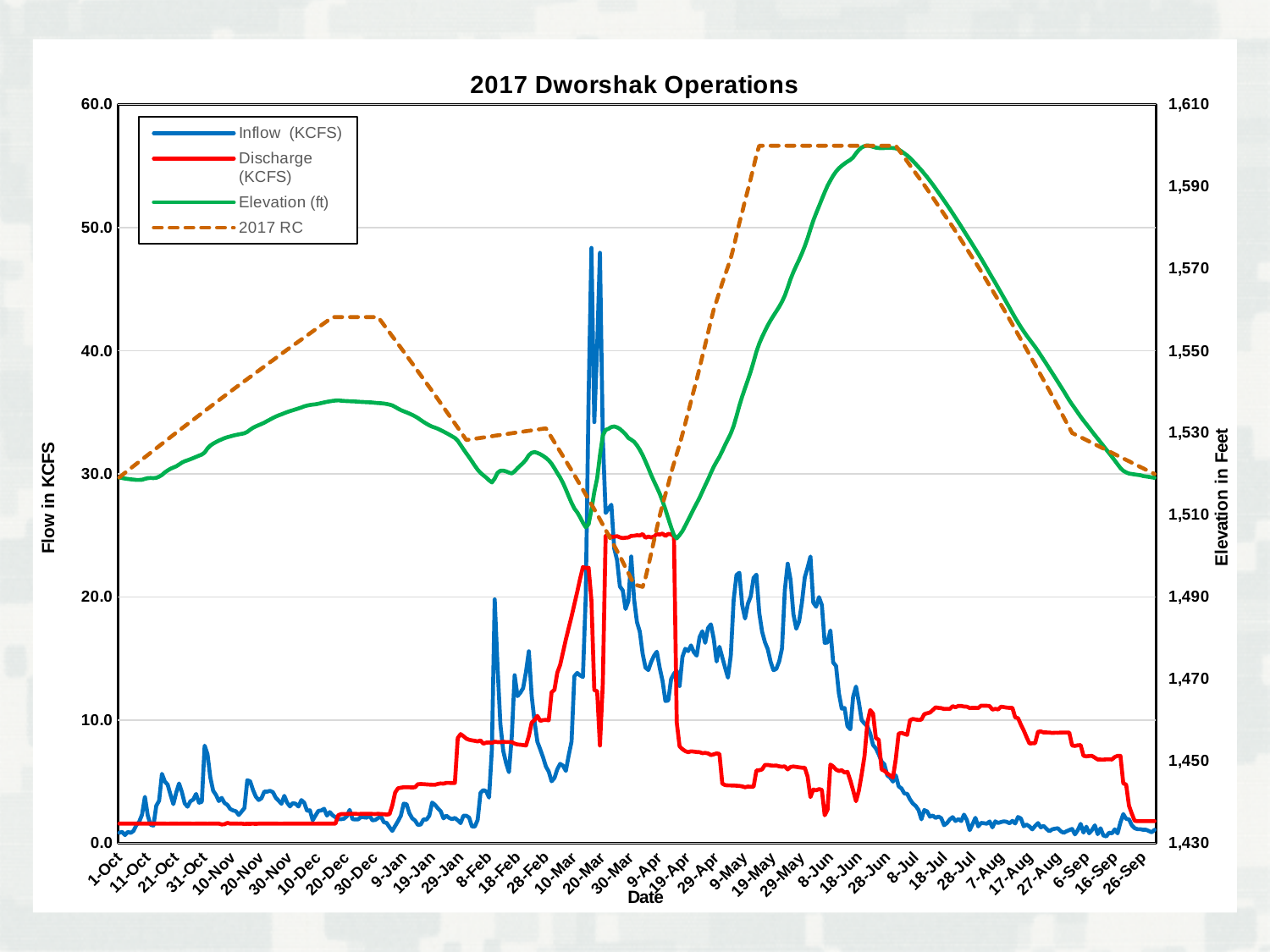
What is the title of the chart? 2017 Dworshak Operations Does the 2017 RC series rise or fall between 9-Apr and 9-May? rise Does the Elevation (ft) series rise or fall between 8-Jul and 26-Sep? fall How many series does the legend list? 4 What kind of chart is shown on the slide? line chart Which series is drawn as a dashed line? 2017 RC Around 20-Mar, which series has the higher flow value, Inflow (KCFS) or Discharge (KCFS)? Inflow (KCFS) Is the Discharge (KCFS) value on 1-Oct greater or less than 10.0? less Is the peak value of the Inflow (KCFS) series greater or less than 40.0? greater Is the Discharge (KCFS) value on 28-Jul greater or less than 10.0? greater